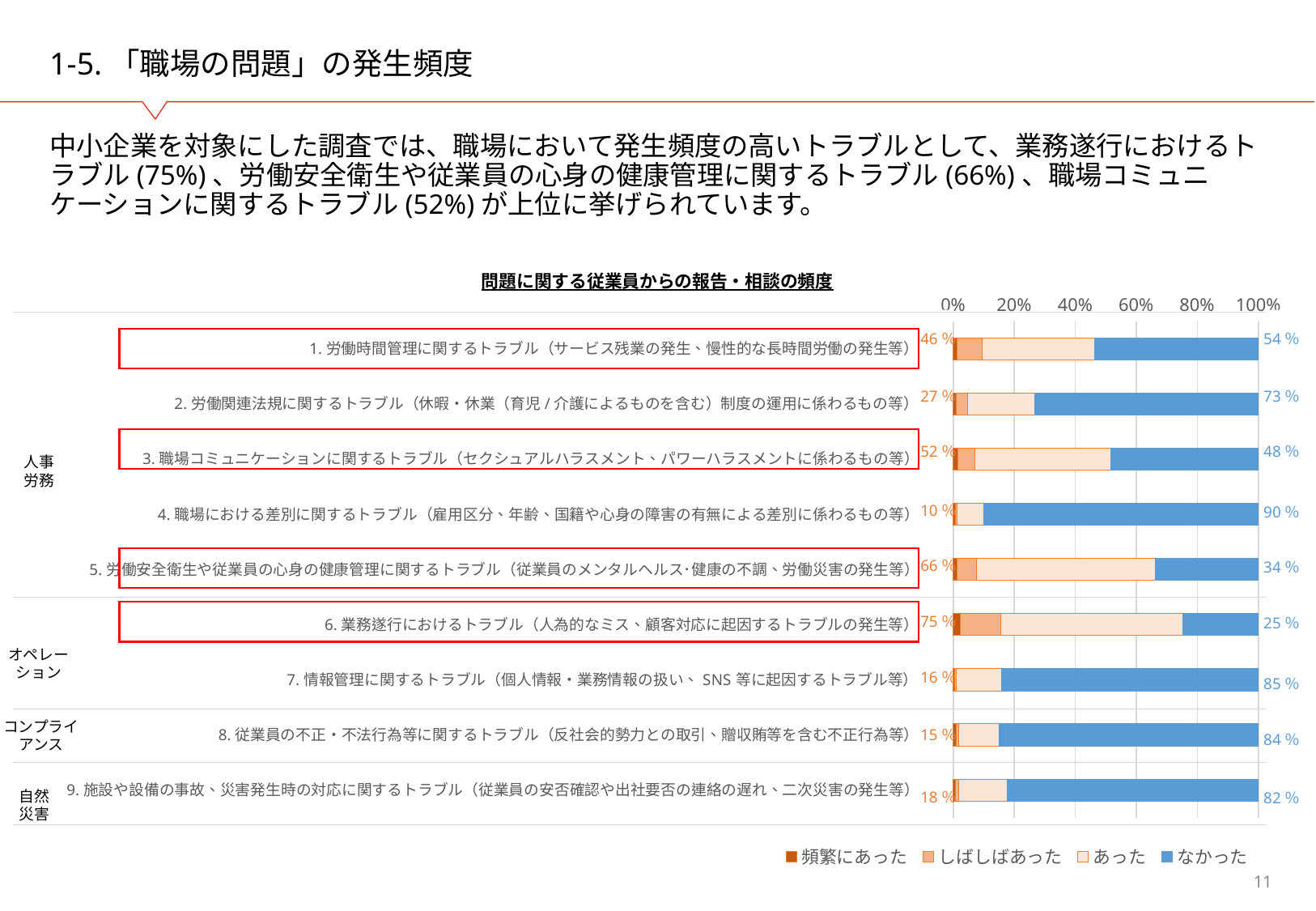
Which has the larger 「なかった」 value, item 1 (労働時間管理に関するトラブル) or item 3 (職場コミュニケーションに関するトラブル)? 1. 労働時間管理に関するトラブル How many categories (trouble types) are plotted in the chart? 9 How many series does the chart legend list? 4 Which item has the highest 「なかった」 value? 4. 職場における差別に関するトラブル Which item has the lowest 「なかった」 value? 6. 業務遂行におけるトラブル What is the orange (occurred) percentage shown for item 5 (労働安全衛生や従業員の心身の健康管理に関するトラブル)? 66 % What is the 「なかった」 value for item 6 (業務遂行におけるトラブル)? 25 % What is the title of the chart? 問題に関する従業員からの報告・相談の頻度 Is the 「なかった」 value for item 2 (労働関連法規に関するトラブル) greater or less than 60%? greater What are the four legend entries of the chart? 頻繁にあった, しばしばあった, あった, なかった What kind of chart is shown on the slide? bar chart What is the difference between the 「なかった」 values of item 4 and item 6? 65 %